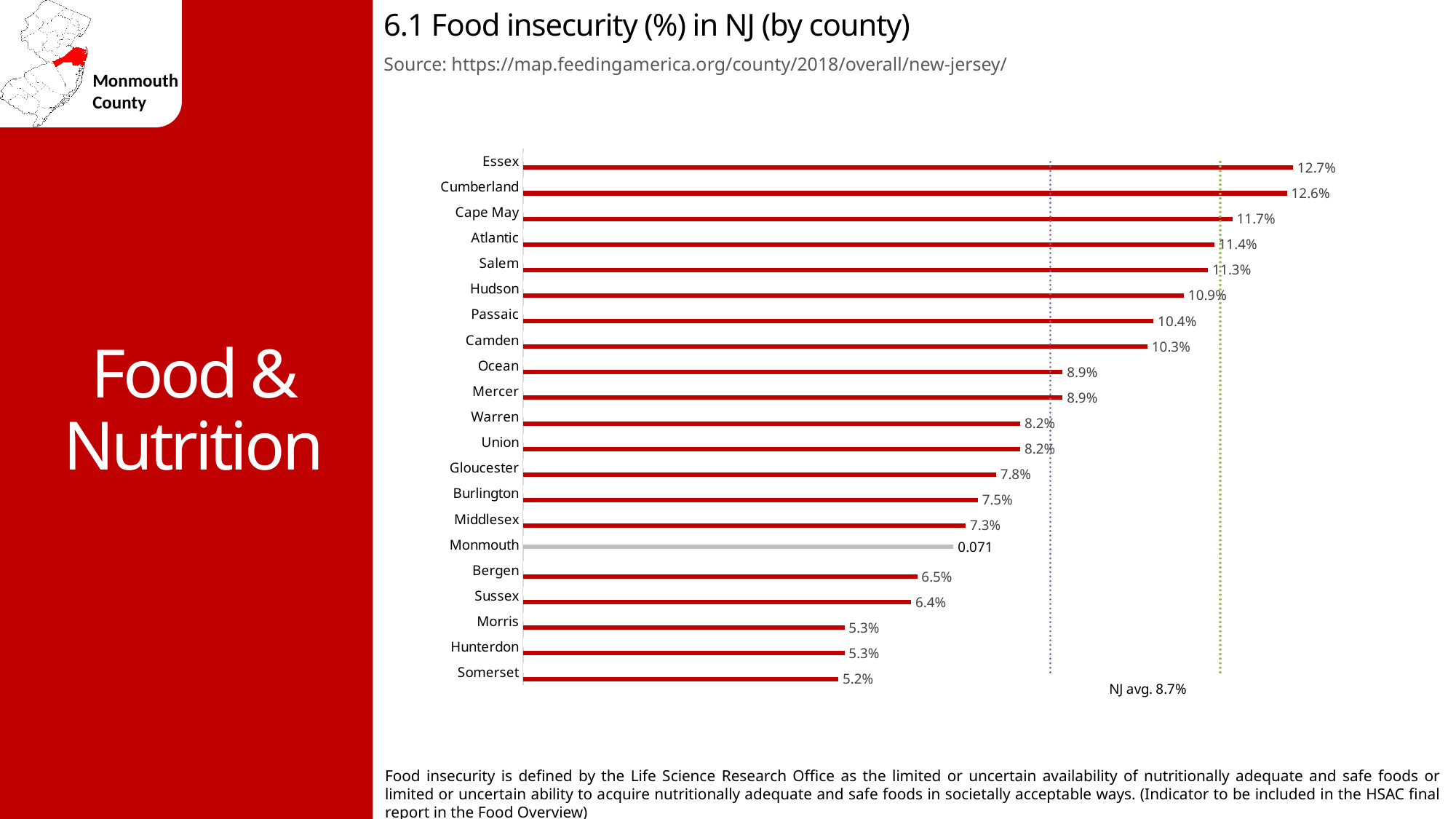
What is the food insecurity value for Essex? 12.7% Which county's bar is coloured grey instead of red? Monmouth What value is labelled on the Monmouth bar? 0.071 Which county has the highest food insecurity value? Essex What is the NJ average food insecurity value noted on the chart? 8.7% Which county has the lowest food insecurity value? Somerset What is the difference between the values for Essex and Somerset? 7.5% What is the difference between the values for Cape May and Passaic? 1.3% What is the food insecurity value for Hudson? 10.9% Which has a higher food insecurity value, Camden or Gloucester? Camden How many counties are shown in the chart? 21 What kind of chart is shown on the slide? Bar chart